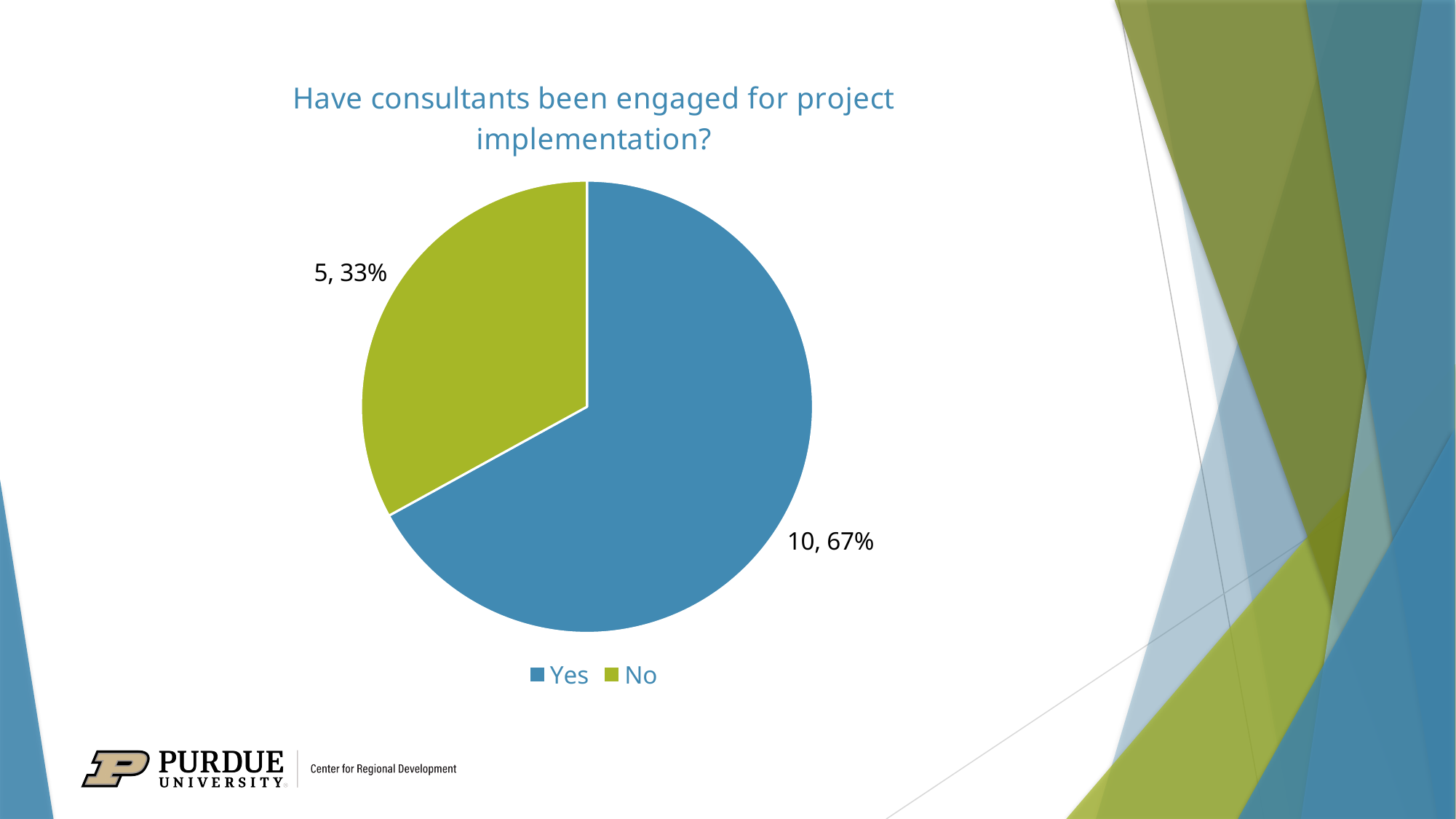
What share of the pie does the Yes slice represent? 67% What share of the pie does the No slice represent? 33% Which category has the largest slice? Yes Which is larger, the Yes slice or the No slice? Yes What is the title of the chart? Have consultants been engaged for project implementation? How many categories does the pie chart have? 2 Which category has the smallest slice? No What kind of chart is shown on the slide? pie chart How many respondents answered No? 5 How many respondents answered Yes? 10 What is the difference between the number of Yes and No responses? 5 What is the total number of responses shown in the pie chart? 15